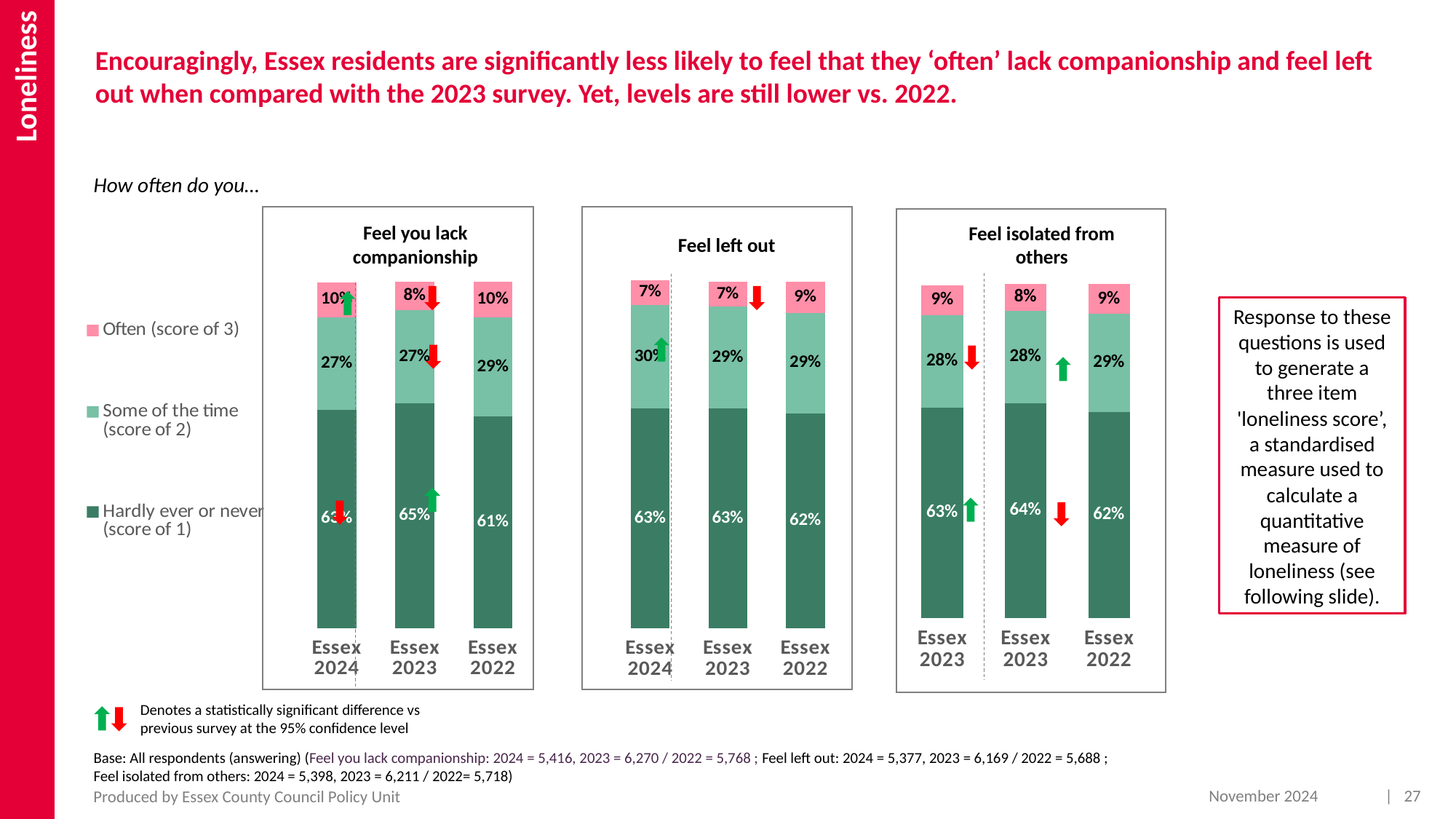
In the 'Feel left out' chart, what is the 'Some of the time (score of 2)' value for Essex 2024? 30% In the 'Feel you lack companionship' chart, what percentage of Essex 2023 respondents answered 'Often (score of 3)'? 8% What type of chart is used for 'Feel isolated from others'? Stacked bar chart How many bars are shown in the 'Feel left out' chart? 3 In the 'Feel isolated from others' chart, what is the 'Hardly ever or never (score of 1)' value for Essex 2022? 62% In the 'Feel left out' chart, which has the larger 'Often (score of 3)' value: Essex 2022 or Essex 2024? Essex 2022 In the 'Feel you lack companionship' chart, which survey year has the highest 'Hardly ever or never (score of 1)' value? Essex 2023 In the 'Feel left out' chart, which survey year has the highest 'Some of the time (score of 2)' value? Essex 2024 In the 'Feel you lack companionship' chart, which survey year has the lowest 'Often (score of 3)' value? Essex 2023 In the 'Feel you lack companionship' chart, what is the difference between the 'Hardly ever or never' values for Essex 2023 and Essex 2022? 4 percentage points How many series does the legend list for these charts? 3 In the 'Feel left out' chart, what is the total of the three segments for the Essex 2022 bar? 100%